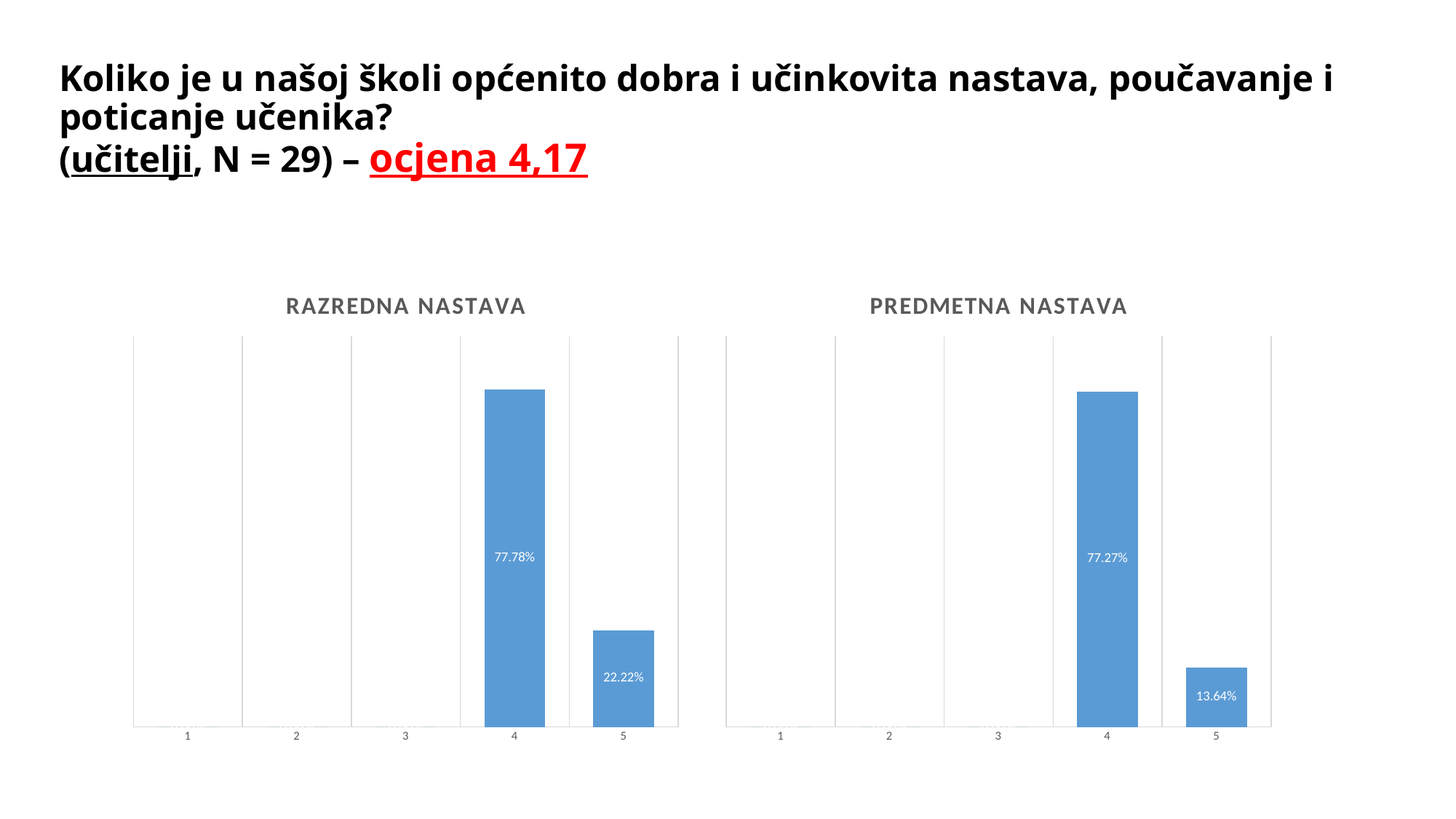
Which chart has the larger value for category 5, RAZREDNA NASTAVA or PREDMETNA NASTAVA? RAZREDNA NASTAVA In the PREDMETNA NASTAVA chart, what is the value for category 4? 77.27% What type of chart is the RAZREDNA NASTAVA chart? Bar chart In the PREDMETNA NASTAVA chart, which category has the highest value? 4 In the RAZREDNA NASTAVA chart, what is the difference between the values for categories 4 and 5? 55.56% What is the title of the chart on the right side of the slide? PREDMETNA NASTAVA In the PREDMETNA NASTAVA chart, what is the value for category 5? 13.64% In the PREDMETNA NASTAVA chart, what is the difference between the values for categories 4 and 5? 63.63% In the RAZREDNA NASTAVA chart, what is the value for category 5? 22.22% How many categories are shown on the x axis of the PREDMETNA NASTAVA chart? 5 In the RAZREDNA NASTAVA chart, which category has the highest value? 4 In the RAZREDNA NASTAVA chart, what is the value for category 4? 77.78%